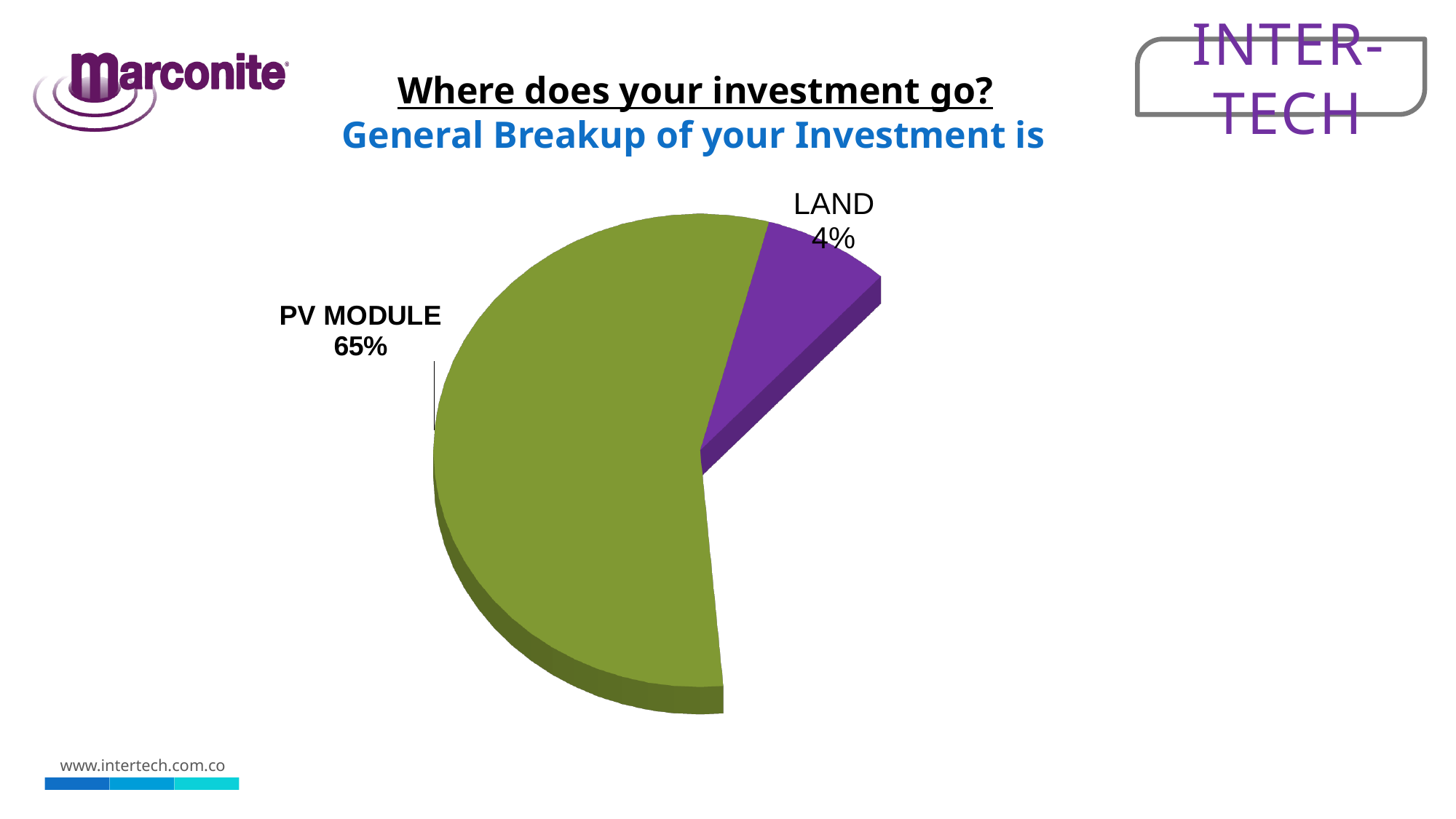
What kind of chart is shown on the slide? Pie chart Which labelled slice of the pie chart is the largest? PV MODULE By how many percentage points does the PV MODULE share exceed the LAND share? 61 percentage points What share of the investment goes to PV MODULE? 65% What colour is the LAND slice? Purple What share of the investment goes to LAND? 4% Which labelled slice of the pie chart is the smallest? LAND How many labelled slices does the pie chart show? 2 What colour is the PV MODULE slice? Green Which is larger, the share for PV MODULE or the share for LAND? PV MODULE